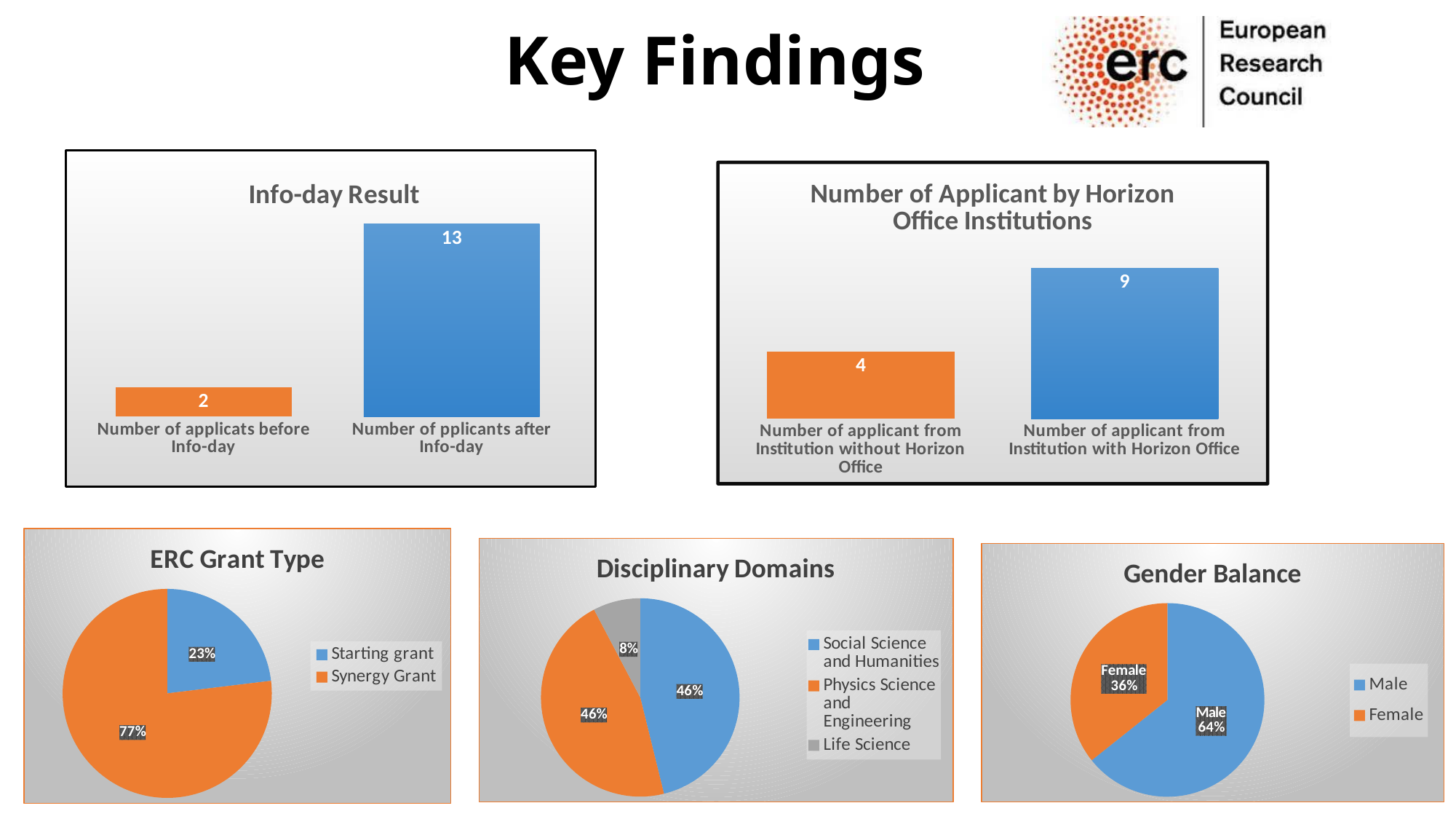
In the 'Info-day Result' chart, what is the number of applicants before Info-day? 2 In the 'Number of Applicant by Horizon Office Institutions' chart, which category has the lower value? Number of applicant from Institution without Horizon Office In the 'Number of Applicant by Horizon Office Institutions' chart, how many applicants came from institutions with a Horizon Office? 9 In the 'Number of Applicant by Horizon Office Institutions' chart, what is the difference between applicants from institutions with and without a Horizon Office? 5 In the 'ERC Grant Type' chart, what share does Synergy Grant have? 77% In the 'Info-day Result' chart, what is the difference between the number of applicants after Info-day and before Info-day? 11 In the 'Gender Balance' chart, what is the share for Male? 64% In the 'Info-day Result' chart, what is the number of applicants after Info-day? 13 What kind of chart is the 'Info-day Result' chart? Bar chart In the 'Disciplinary Domains' chart, what share does Life Science have? 8% How many categories does the legend of the 'Disciplinary Domains' chart list? 3 In the 'Gender Balance' chart, which is larger, Male or Female? Male